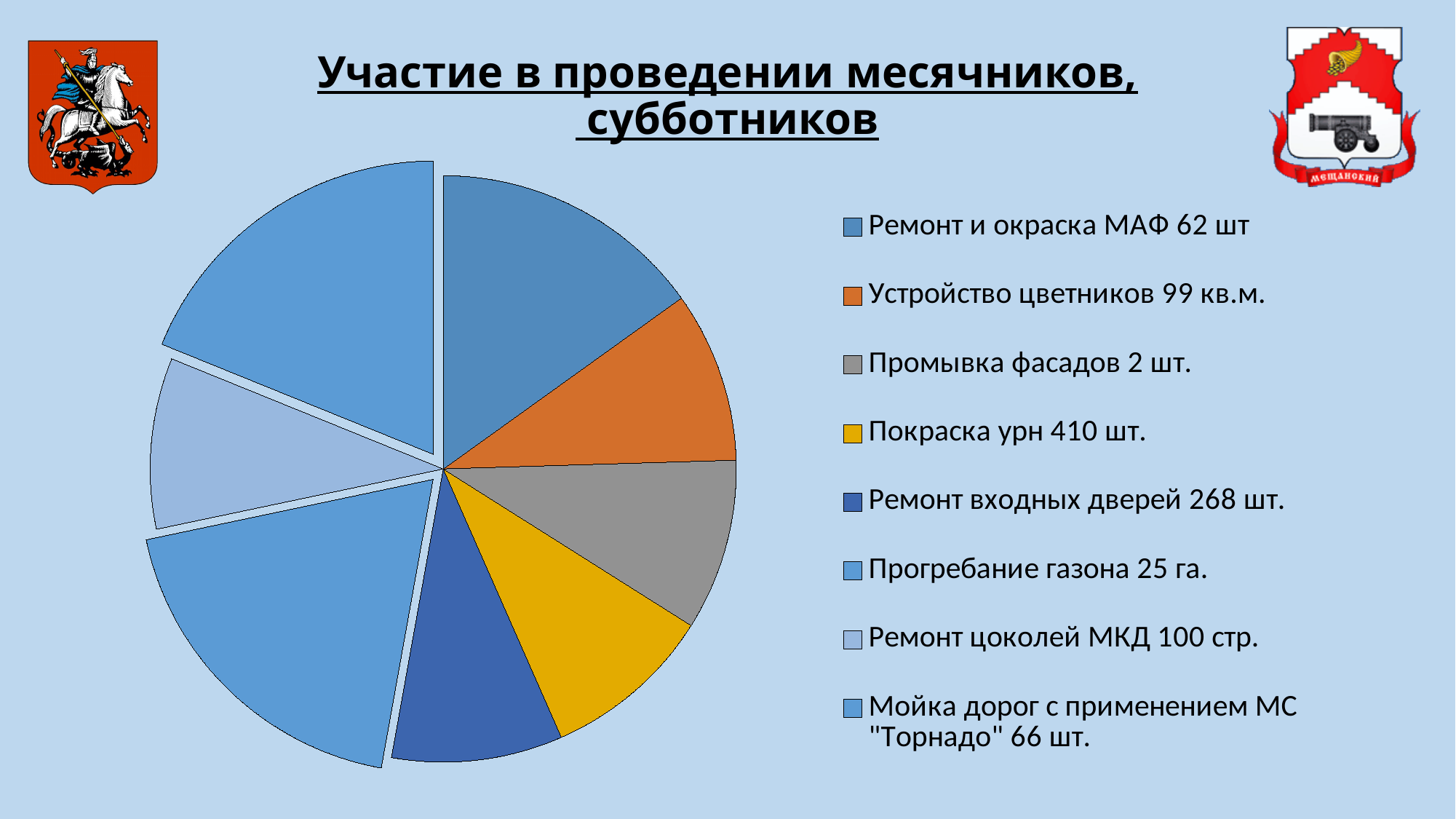
According to the legend, how many шт. are given for Покраска урн? 410 шт. According to the legend, how many шт. are given for Ремонт и окраска МАФ? 62 шт What is the title of the chart on the slide? Участие в проведении месячников, субботников According to the legend, how many шт. are given for Ремонт входных дверей? 268 шт. How many slices does the pie chart have? 8 According to the legend, what quantity is given for Ремонт цоколей МКД? 100 стр. According to the legend, how many шт. are given for Мойка дорог с применением МС "Торнадо"? 66 шт. What kind of chart is shown on the slide? pie chart According to the legend, what quantity is given for Прогребание газона? 25 га. What colour is the slice for Покраска урн? yellow How many entries does the legend list? 8 According to the legend, what quantity is given for Устройство цветников? 99 кв.м.